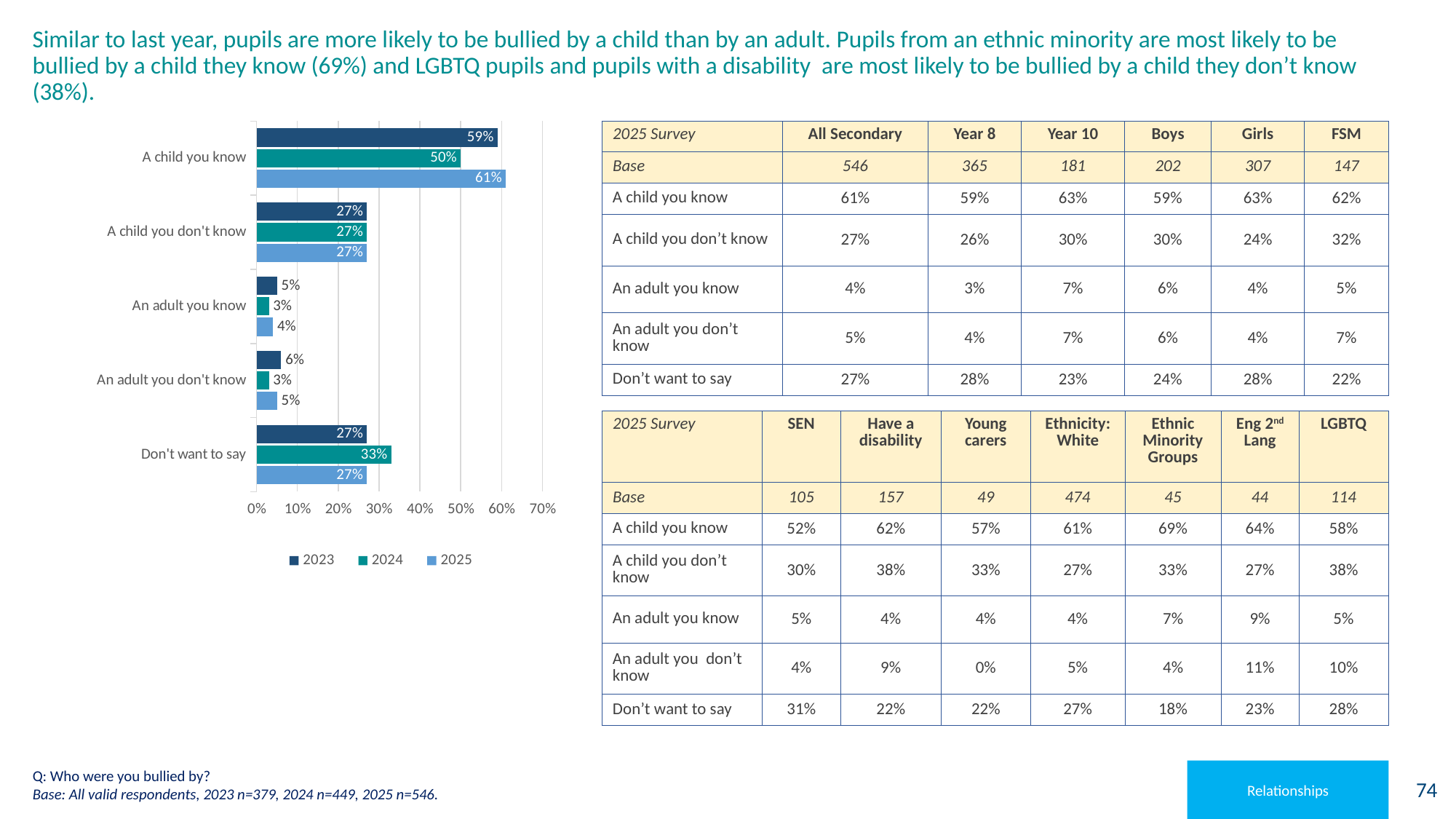
What is the difference between the 2025 and 2024 values for 'A child you know'? 11 percentage points Which category has the lowest 2024 value? An adult you know (3%) and An adult you don't know (3%) How many categories are shown on the chart? 5 What is the 2023 value for 'An adult you don't know'? 6% What is the 2024 value for 'Don't want to say'? 33% How many series does the legend list? 3 Which is larger: the 2023 value for 'A child you know' or the 2024 value for 'A child you know'? 2023 (59%) What are the series listed in the chart legend? 2023, 2024, 2025 Which category has the highest 2025 value? A child you know What is the 2025 value for 'A child you know'? 61% What is the maximum value shown on the chart's x axis? 70% What kind of chart is shown on the slide? Bar chart